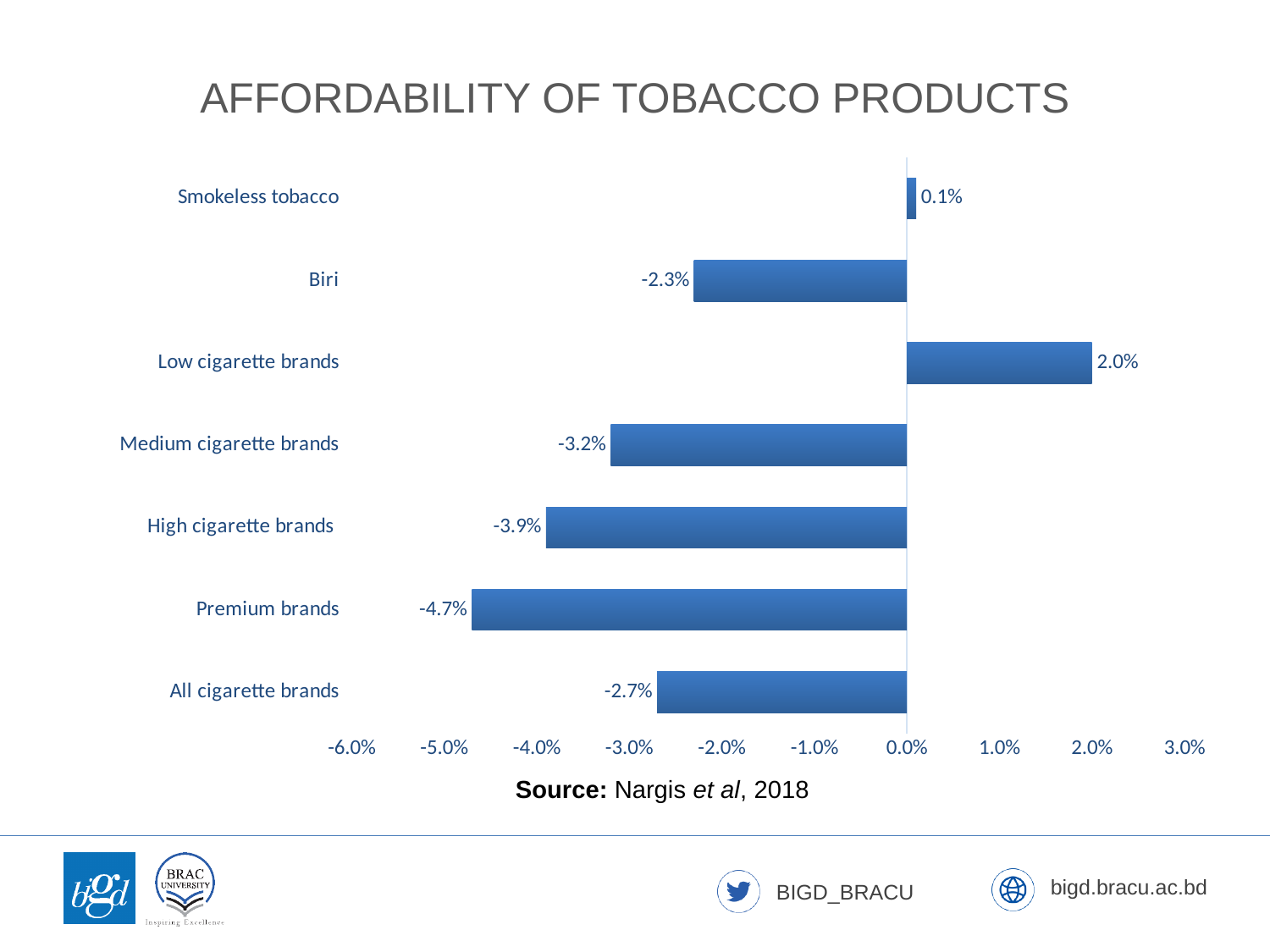
Which category has the highest value? Low cigarette brands Is the value for Medium cigarette brands greater or less than -3.0%? less Which category has the lowest value? Premium brands How many categories are shown in the chart? 7 What is the value for Smokeless tobacco? 0.1% What is the title of the chart? AFFORDABILITY OF TOBACCO PRODUCTS Which is larger, the value for All cigarette brands or the value for Biri? Biri What kind of chart is shown on the slide? Bar chart What is the value for Low cigarette brands? 2.0% What is the value for Biri? -2.3% What is the value for Premium brands? -4.7% What is the difference between the values for High cigarette brands and Medium cigarette brands? 0.7%